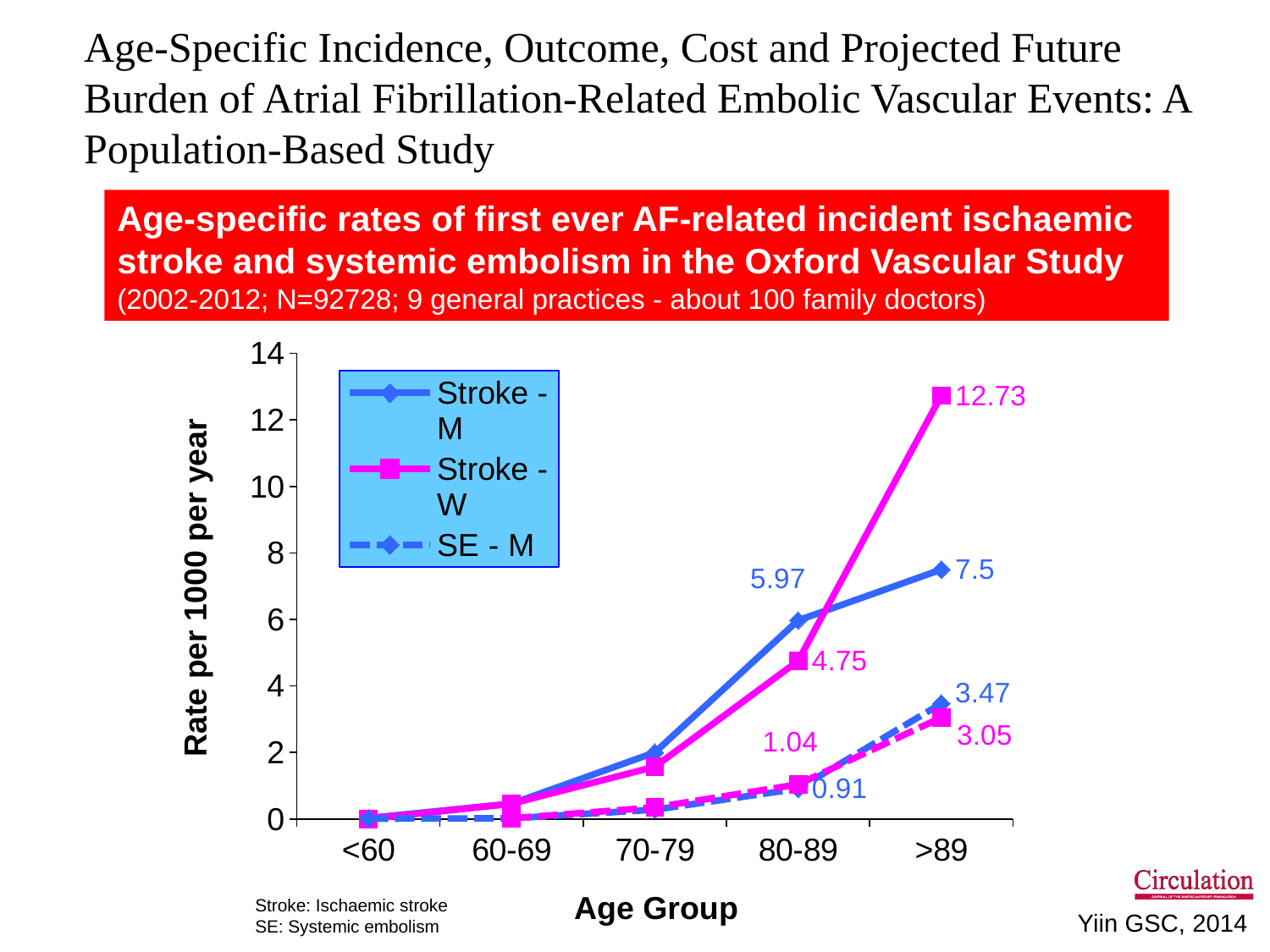
What kind of chart is shown on the slide? line chart Does the Stroke - W rate rise or fall as age group increases? rise What is the rate for SE - M in the >89 age group? 3.47 How many series does the legend list? 3 What is the rate for Stroke - M in the 80-89 age group? 5.97 What is the rate for Stroke - W in the >89 age group? 12.73 In the 80-89 age group, which is larger: Stroke - M or Stroke - W? Stroke - M What is the rate for Stroke - M in the >89 age group? 7.5 How many age groups are shown on the x axis? 5 What is the rate for Stroke - W in the 80-89 age group? 4.75 Is the Stroke - M rate for the 70-79 age group greater or less than 4? less What is the difference between the Stroke - W and Stroke - M rates in the >89 age group? 5.23